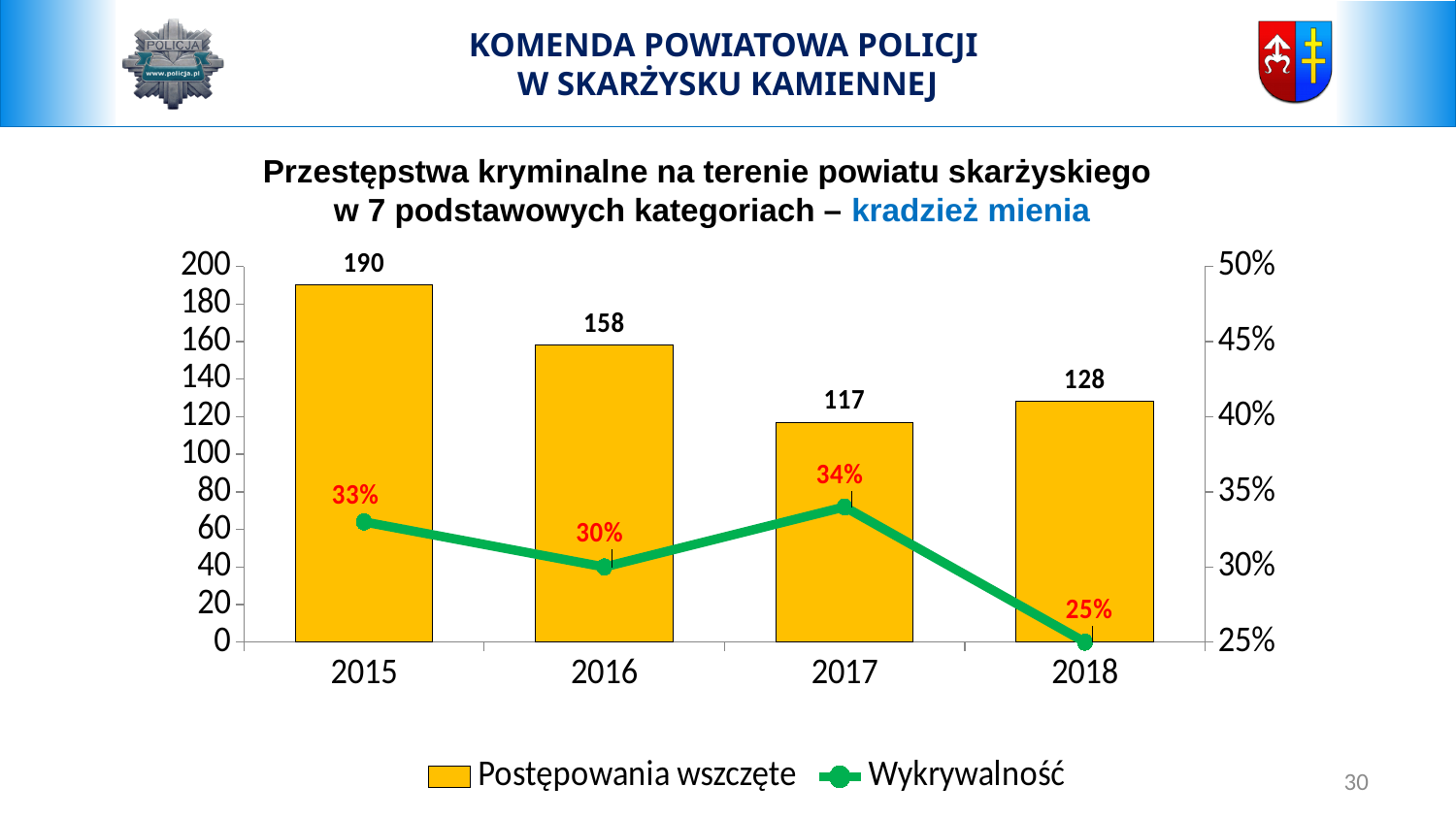
How many series does the legend list? 2 What kind of chart is used for the Postępowania wszczęte series? bar chart Does the Wykrywalność line rise or fall from 2017 to 2018? fall What is the Wykrywalność value for 2017? 34% What is the difference between Postępowania wszczęte in 2015 and 2016? 32 What is the value of Postępowania wszczęte for 2015? 190 Which year has the lowest Wykrywalność? 2018 Is the value of Postępowania wszczęte for 2017 greater or less than 120? less Which year has the highest value of Postępowania wszczęte? 2015 Which year has a higher value of Postępowania wszczęte, 2017 or 2018? 2018 What is the value of Postępowania wszczęte for 2018? 128 How many years are shown on the x axis? 4